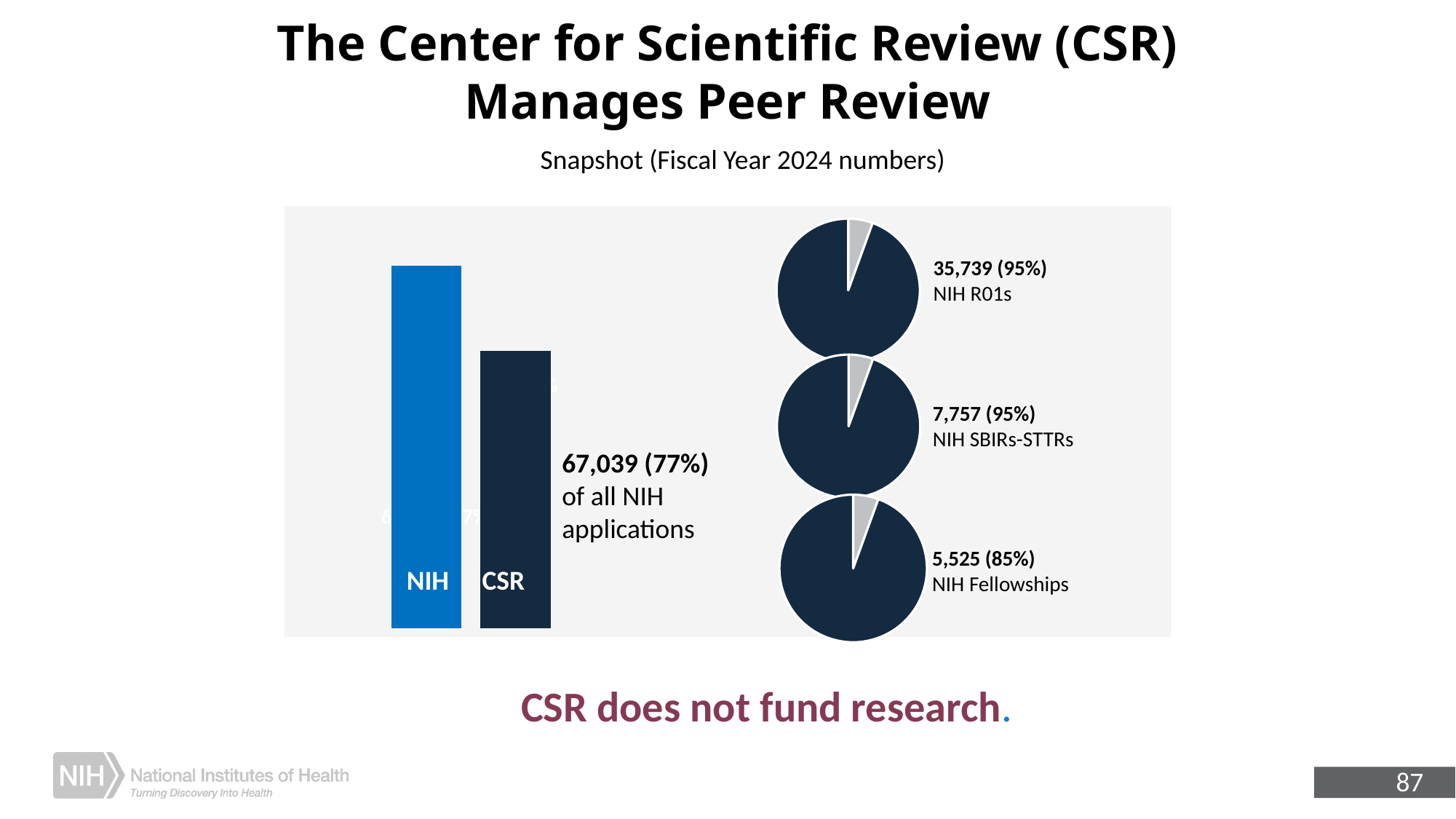
In the bottom pie chart (NIH Fellowships), what share of the pie is the dark slice? 85% In the bar chart on the left, how many applications does the CSR bar represent? 67,039 In the middle pie chart (NIH SBIRs-STTRs), how many applications does the dark slice represent? 7,757 In the bar chart on the left, which bar is taller, NIH or CSR? NIH How many pie charts are shown on the right side of the slide? 3 In the bar chart on the left, what percentage of all NIH applications does CSR account for? 77% Among the three pie charts on the right, which category has the lowest percentage for the dark slice? NIH Fellowships In the top pie chart (NIH R01s), what share of the pie is the dark slice? 95% In the bottom pie chart (NIH Fellowships), how many applications does the dark slice represent? 5,525 In the top pie chart (NIH R01s), how many applications does the dark slice represent? 35,739 In the bar chart on the left, how many bars are shown? 2 In the bar chart on the left, what kind of chart is it? bar chart